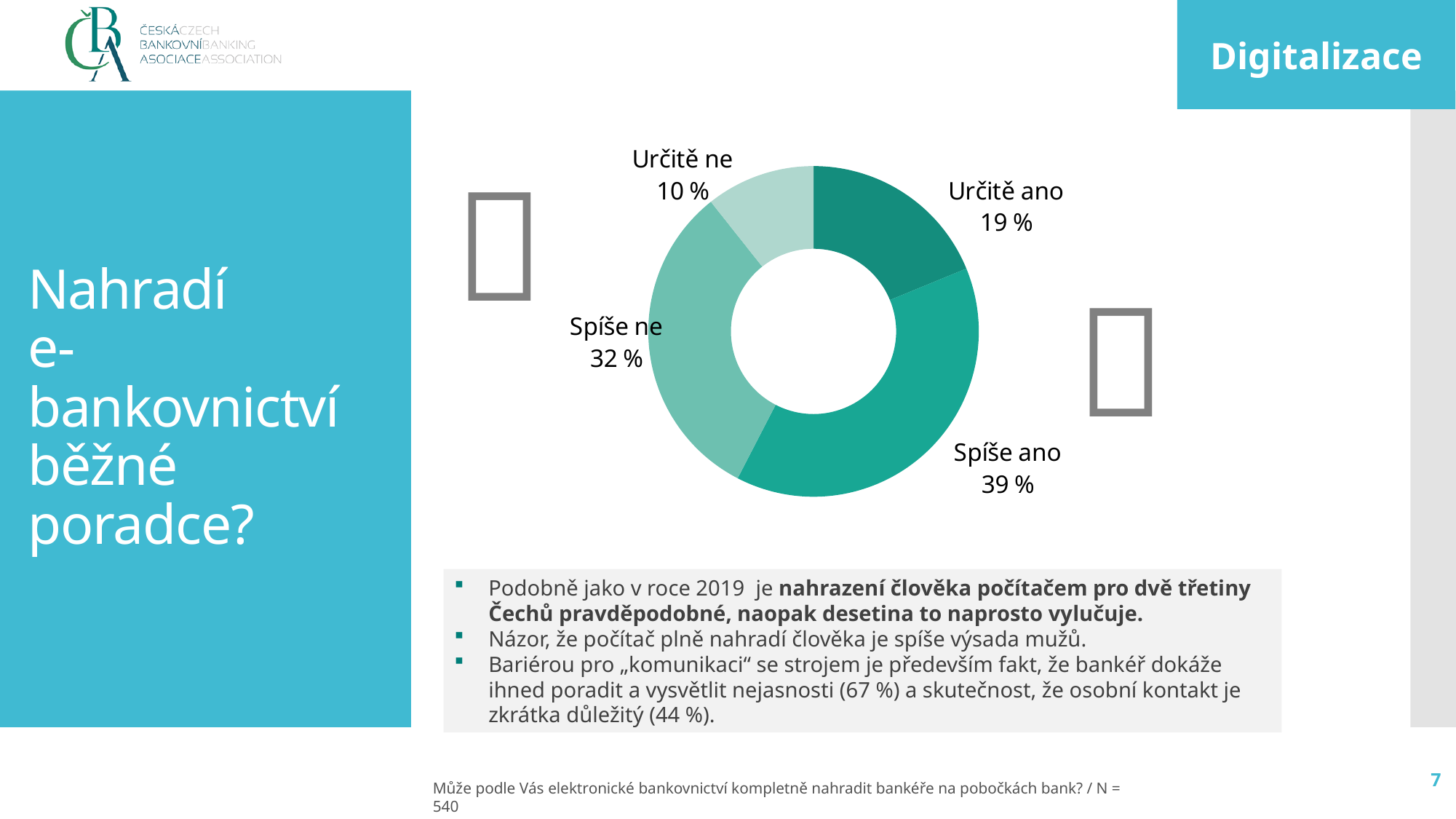
Which is larger, the share for "Určitě ano" or the share for "Spíše ne"? Spíše ne What percentage of respondents answered "Spíše ano"? 39 % What is the combined share of "Určitě ano" and "Spíše ano"? 58 % What type of chart is shown on the slide? Doughnut (pie) chart What percentage of respondents answered "Spíše ne"? 32 % What percentage of respondents answered "Určitě ne"? 10 % Which response category has the smallest share of the chart? Určitě ne What percentage of respondents answered "Určitě ano"? 19 % What is the combined share of "Spíše ne" and "Určitě ne"? 42 % What is the difference in percentage points between "Spíše ano" and "Spíše ne"? 7 Which response category has the largest share of the chart? Spíše ano How many response categories are shown in the chart? 4